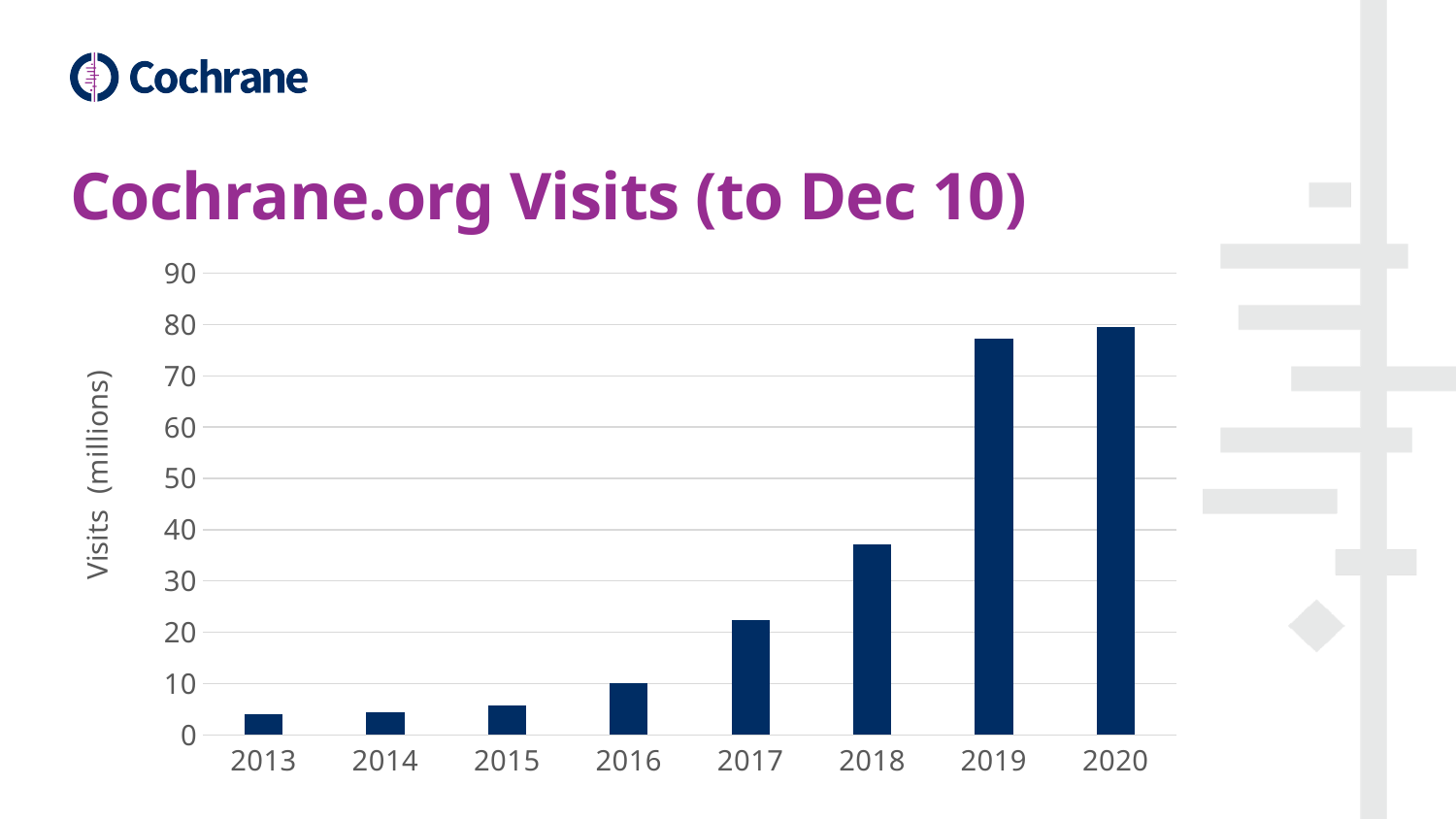
Which year has the highest number of visits? 2020 What kind of chart is shown on the slide? bar chart Is the value for 2019 greater or less than 70? greater Is the value for 2018 greater or less than 40? less Is the value for 2015 greater or less than 10? less Which is larger, the value for 2018 or the value for 2017? 2018 Do the visits generally rise or fall from 2013 to 2020? rise How many years are shown on the x axis? 8 What is the title of the chart? Cochrane.org Visits (to Dec 10) What is the label on the vertical axis? Visits (millions)